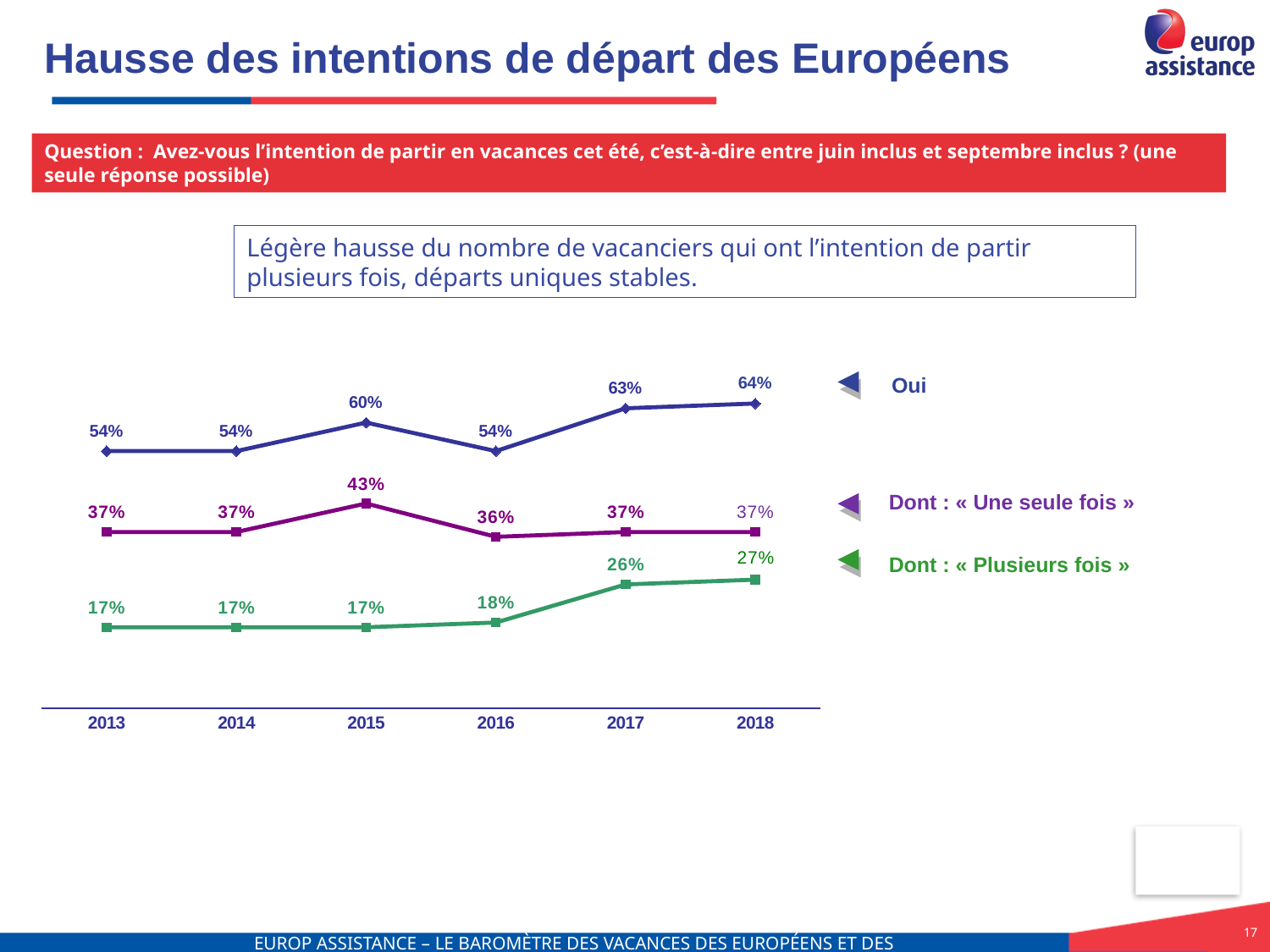
What colour is the line for the "Oui" series? Blue What kind of chart is shown on the slide? Line chart What is the difference between the "Oui" value in 2018 and the "Oui" value in 2013? 10% What is the value of the "Dont : « Une seule fois »" series in 2015? 43% How many years are shown on the x axis? 6 What is the value of the "Dont : « Plusieurs fois »" series in 2016? 18% Which is larger: the "Dont : « Plusieurs fois »" value in 2017 or in 2016? 2017 What is the value of the "Oui" series in 2018? 64% How many series does the legend list? 3 In which year is the "Dont : « Une seule fois »" series at its lowest? 2016 Does the "Dont : « Plusieurs fois »" series rise or fall between 2016 and 2018? Rise In which year is the "Oui" series at its highest? 2018